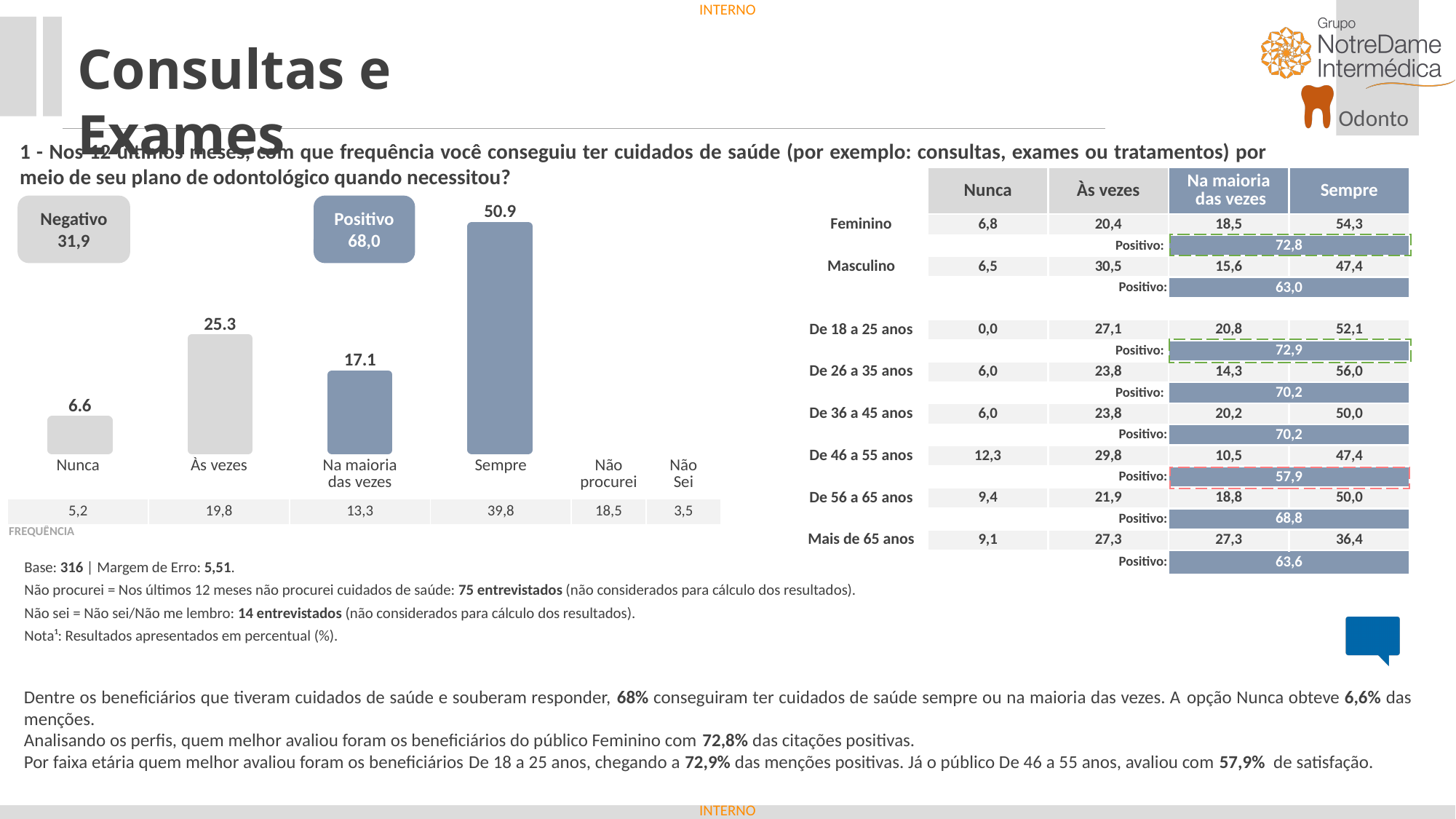
What is the value of the bar for Às vezes? 25.3 What is the value of the bar for Nunca? 6.6 Which category has the highest bar? Sempre What is the difference between the values for Às vezes and Na maioria das vezes? 8.2 What value is shown in the Positivo box above the chart? 68,0 What kind of chart is shown on the slide? bar chart What is the value of the bar for Sempre? 50.9 What is the difference between the values for Sempre and Às vezes? 25.6 Which category has the lowest bar? Nunca How many bars are plotted in the chart? 4 What is the value of the bar for Na maioria das vezes? 17.1 Which is larger, the value for Às vezes or the value for Na maioria das vezes? Às vezes